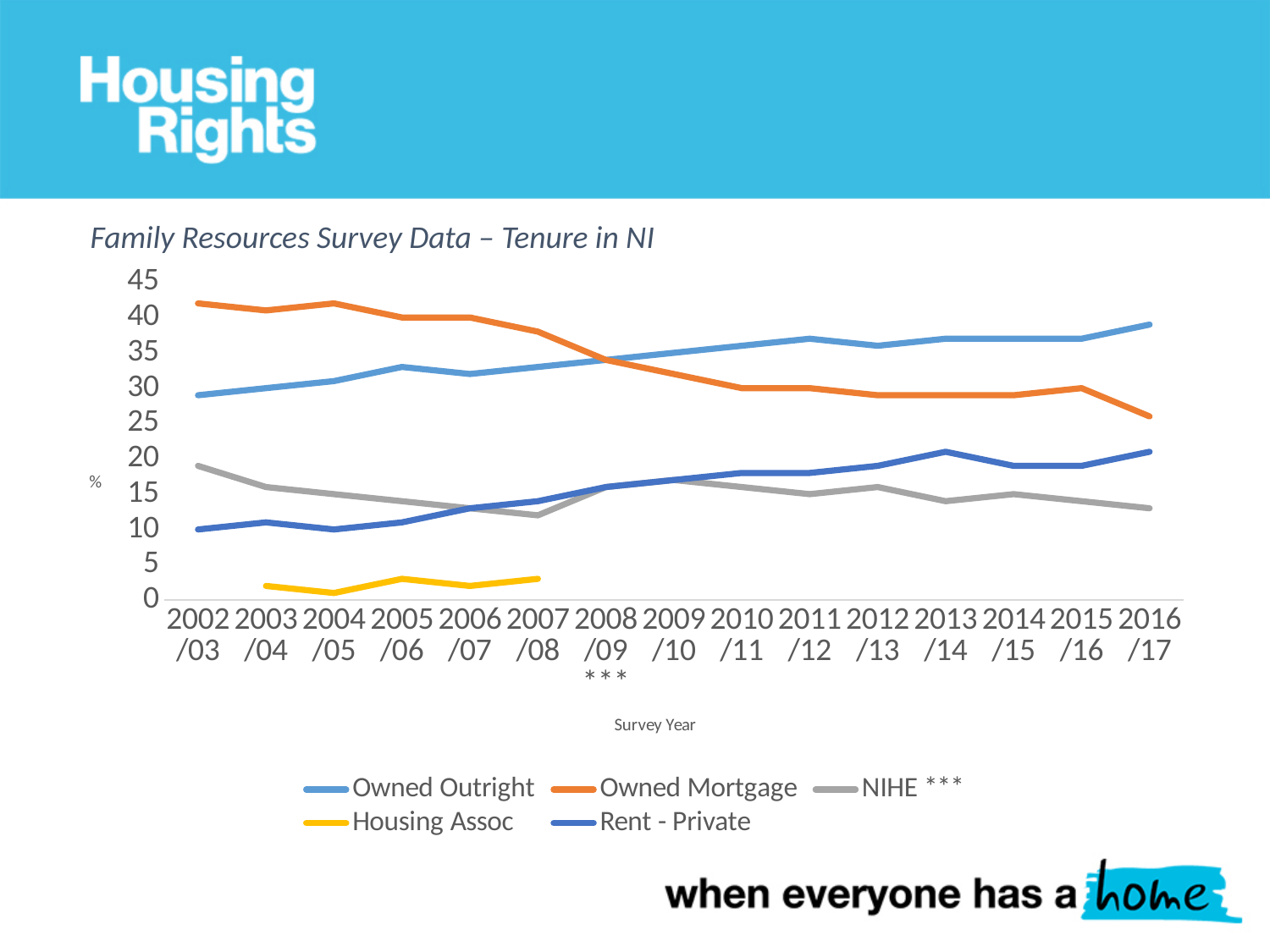
Does the Owned Outright line rise or fall from 2002/03 to 2016/17? Rise Is the value for Housing Assoc in 2004/05 greater or less than 5? less What is the title of the chart? Family Resources Survey Data – Tenure in NI What is the label on the x axis? Survey Year Which series has the lowest value in 2016/17? NIHE *** Does the Owned Mortgage line rise or fall from 2002/03 to 2016/17? Fall Is the value for Owned Mortgage in 2002/03 greater or less than 40? greater Which series has the highest value in 2002/03? Owned Mortgage What kind of chart is shown on the slide? Line chart How many survey years are shown along the x axis? 15 How many series does the legend list? 5 In 2016/17, which is larger: Owned Outright or Owned Mortgage? Owned Outright